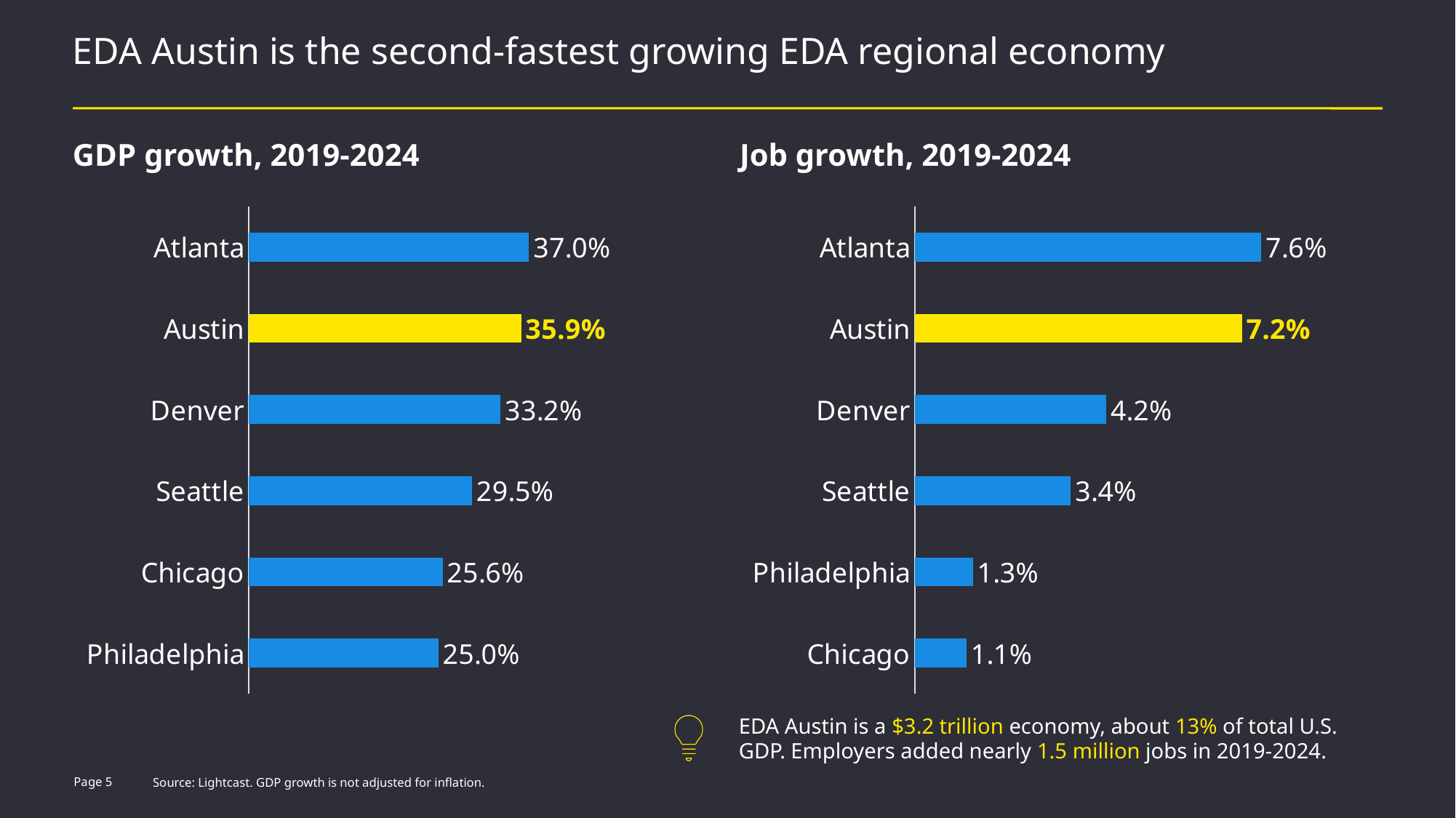
In the GDP growth, 2019-2024 chart, what is the difference between Atlanta and Philadelphia? 12.0% What kind of chart is the Job growth, 2019-2024 chart? Bar chart In the GDP growth, 2019-2024 chart, which is larger, Denver or Seattle? Denver In the Job growth, 2019-2024 chart, what is the difference between Atlanta and Austin? 0.4% In the GDP growth, 2019-2024 chart, what is the value for Chicago? 25.6% In the Job growth, 2019-2024 chart, which is larger, Seattle or Philadelphia? Seattle In the Job growth, 2019-2024 chart, which city's bar is highlighted in yellow? Austin In the GDP growth, 2019-2024 chart, which city has the highest value? Atlanta In the GDP growth, 2019-2024 chart, what is the value for Austin? 35.9% In the Job growth, 2019-2024 chart, what is the value for Denver? 4.2% How many cities are shown in the GDP growth, 2019-2024 chart? 6 In the Job growth, 2019-2024 chart, which city has the lowest value? Chicago